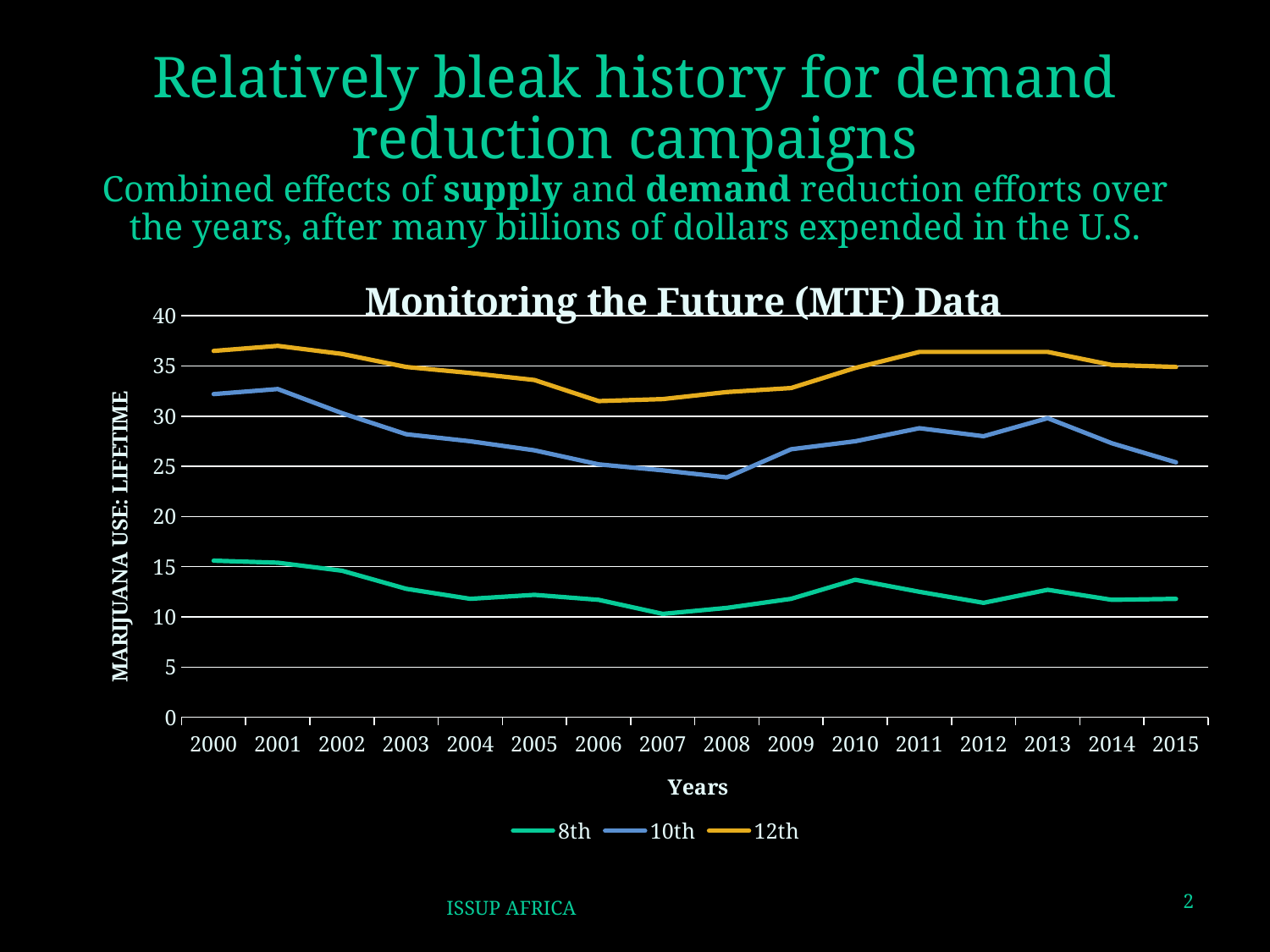
What kind of chart is shown on the slide? line chart Is the value for 12th in 2000 greater or less than 35? greater Is the value for 10th in 2001 greater or less than 30? greater How many years are plotted along the x axis? 16 Which series has the highest values across all years? 12th Is the value for 12th in 2006 greater or less than 30? greater What is the label of the vertical axis? MARIJUANA USE: LIFETIME Does the 10th series rise or fall from 2001 to 2008? fall In which year is the 8th series at its lowest? 2007 How many series does the legend list? 3 What is the title of the chart? Monitoring the Future (MTF) Data